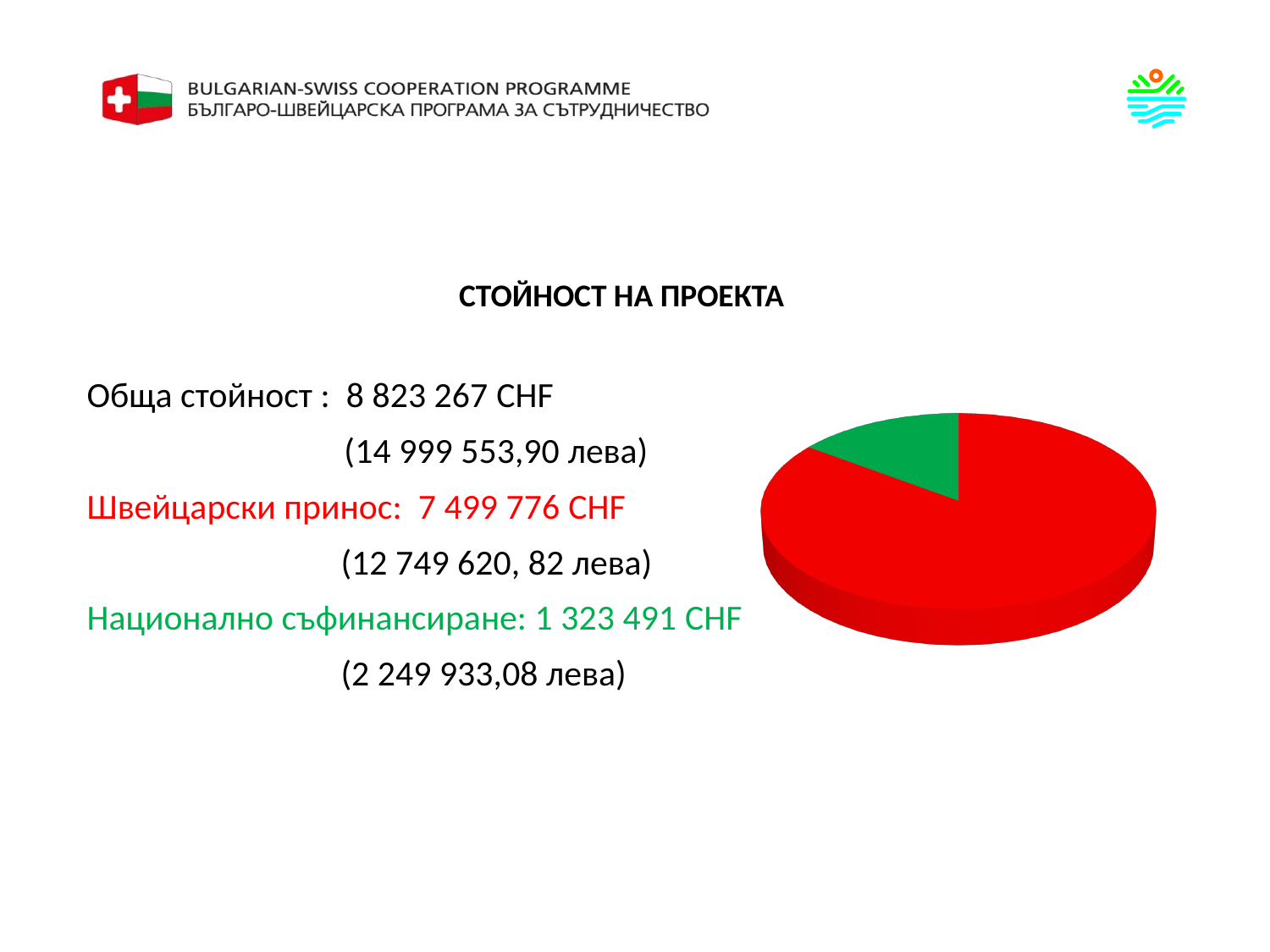
Which slice of the pie chart is larger, the red one or the green one? the red one How many slices does the pie chart have? 2 What colour is the slice representing the Swiss contribution? red What share of the total project value does the national co-financing represent? 15% Which contribution does the largest slice of the pie chart represent? Швейцарски принос Which contribution does the smallest slice of the pie chart represent? Национално съфинансиране What is the title shown above the chart on the slide? СТОЙНОСТ НА ПРОЕКТА What is the value of the Швейцарски принос (Swiss contribution) in CHF? 7 499 776 CHF What kind of chart is shown on the slide? pie chart What is the difference in CHF between the Swiss contribution and the national co-financing? 6 176 285 CHF What is the value of the Национално съфинансиране (national co-financing) in CHF? 1 323 491 CHF What is the total project value (Обща стойност) in CHF? 8 823 267 CHF